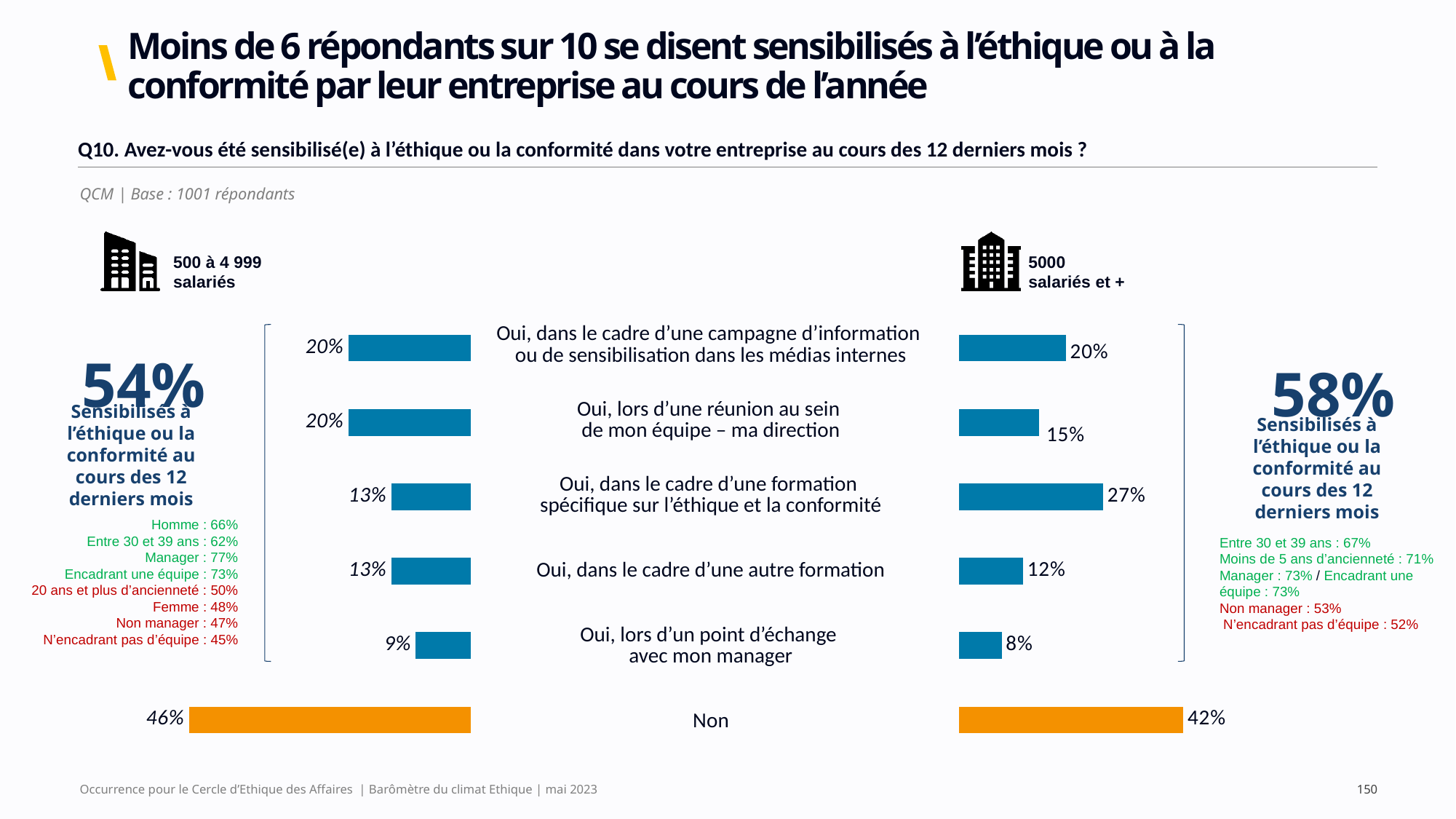
In the chart for 5000 salariés et +, which of the "Oui" categories has the highest value? Oui, dans le cadre d'une formation spécifique sur l'éthique et la conformité In the chart for 500 à 4 999 salariés, what is the value for "Non"? 46% What kind of chart is used to show the results for 5000 salariés et +? Bar chart What is the difference between the "Non" value for 500 à 4 999 salariés and the "Non" value for 5000 salariés et +? 4 percentage points In the chart for 5000 salariés et +, what is the value for "Oui, lors d'un point d'échange avec mon manager"? 8% How many categories are shown in the chart for 500 à 4 999 salariés? 6 What colour is the bar for "Non" in both charts? Orange Which is larger: the value for "Oui, lors d'une réunion au sein de mon équipe – ma direction" for 500 à 4 999 salariés or for 5000 salariés et +? 500 à 4 999 salariés In the chart for 500 à 4 999 salariés, which category has the lowest value? Oui, lors d'un point d'échange avec mon manager In the chart for 5000 salariés et +, which category has the highest value? Non In the chart for 500 à 4 999 salariés, what is the value for "Oui, dans le cadre d'une autre formation"? 13% In the chart for 5000 salariés et +, what is the value for "Oui, dans le cadre d'une formation spécifique sur l'éthique et la conformité"? 27%